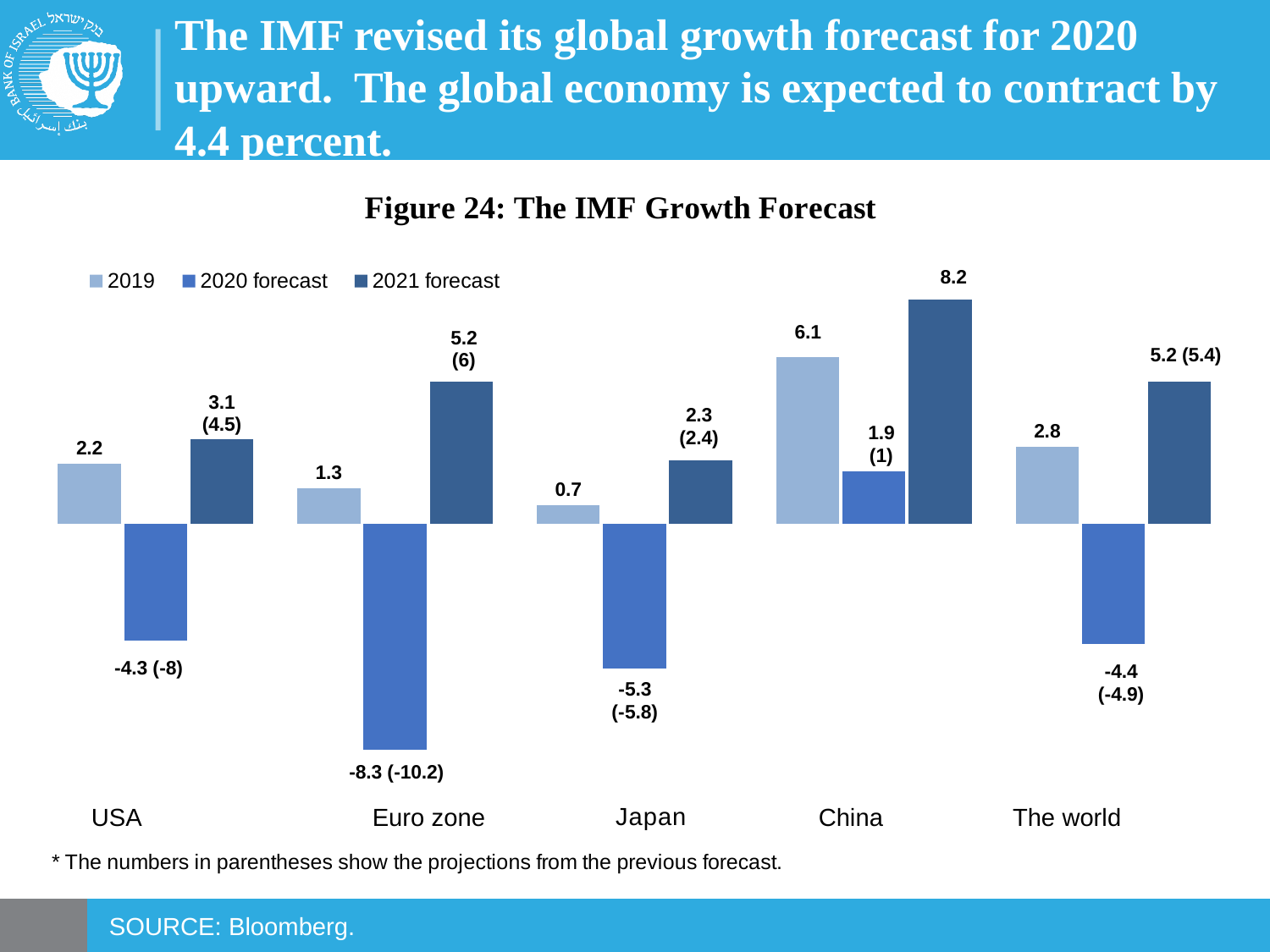
What is the title of the chart on the slide? Figure 24: The IMF Growth Forecast What is the 2019 value for China in Figure 24? 6.1 In Figure 24, is the 2019 value for China larger or smaller than the 2019 value for The world? larger How many series does the legend of Figure 24 list? 3 Which category has the highest 2021 forecast in Figure 24? China Which category has the lowest 2020 forecast in Figure 24? Euro zone What is the 2021 forecast for Japan in Figure 24? 2.3 In Figure 24, what is the difference between the 2021 forecast and the 2019 value for the USA? 0.9 What kind of chart is Figure 24? bar chart How many categories are shown on the x axis of Figure 24? 5 In Figure 24, what was the previous 2020 forecast for the USA, shown in parentheses? -8 What is the current 2020 forecast for the Euro zone in Figure 24? -8.3